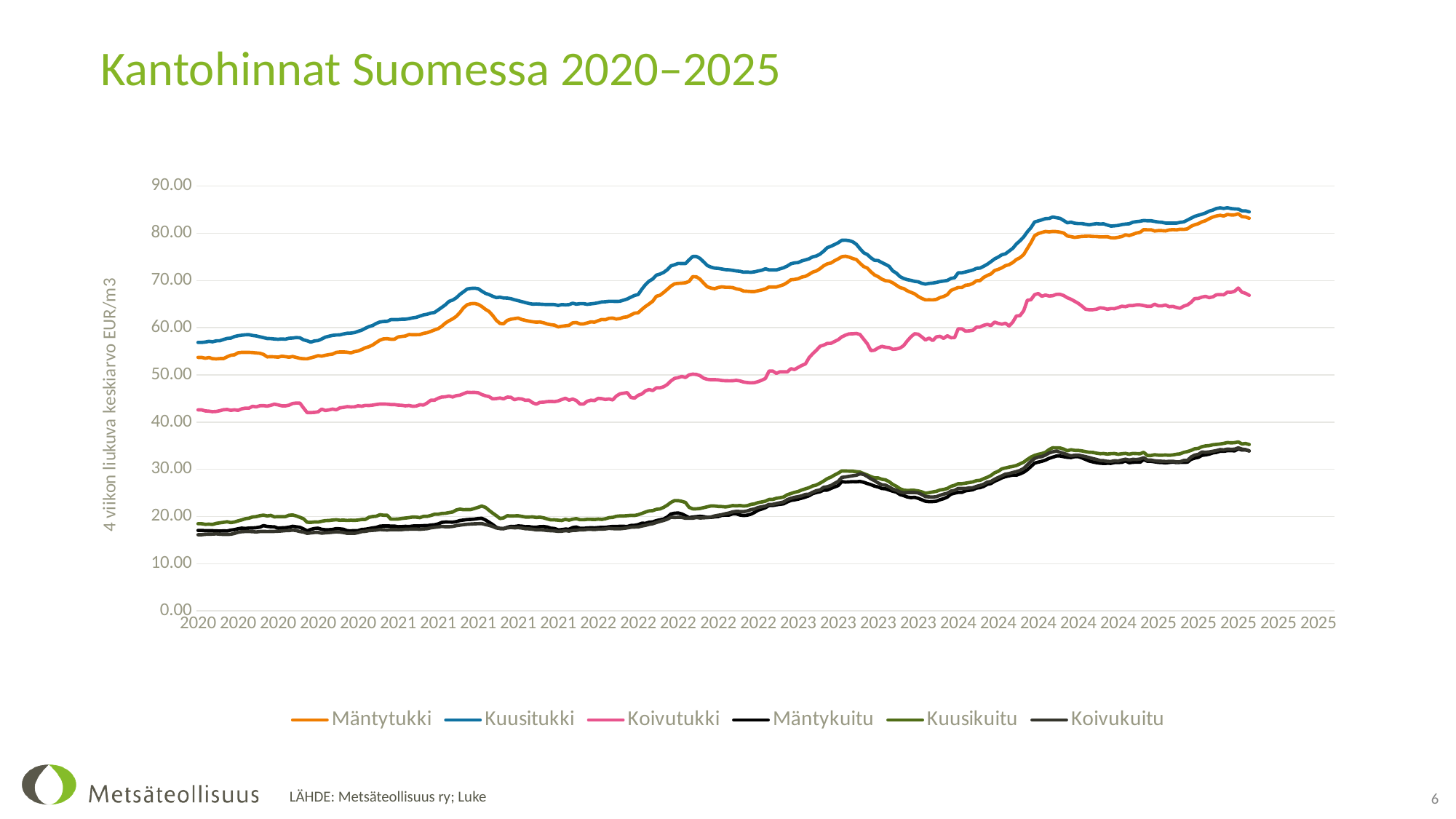
Do the values for Koivutukki rise or fall from 2020 to 2025 overall? rise At the start of 2020, which is larger, Kuusikuitu or Mäntykuitu? Kuusikuitu What is the label on the vertical axis? 4 viikon liukuva keskiarvo EUR/m3 Is the value for Kuusitukki at the start of 2020 greater or less than 50? greater How many series does the legend list? 6 What kind of chart is shown on the slide? line chart At the end of the series in 2025, which is larger, Mäntytukki or Koivutukki? Mäntytukki Is the value for Mäntykuitu at the end of the series in 2025 greater or less than 30? greater Which series has the highest values across the whole period? Kuusitukki What is the title of the chart? Kantohinnat Suomessa 2020–2025 Is the value for Koivutukki at the start of 2020 greater or less than 50? less Do the values for Kuusitukki rise or fall from 2020 to 2025 overall? rise